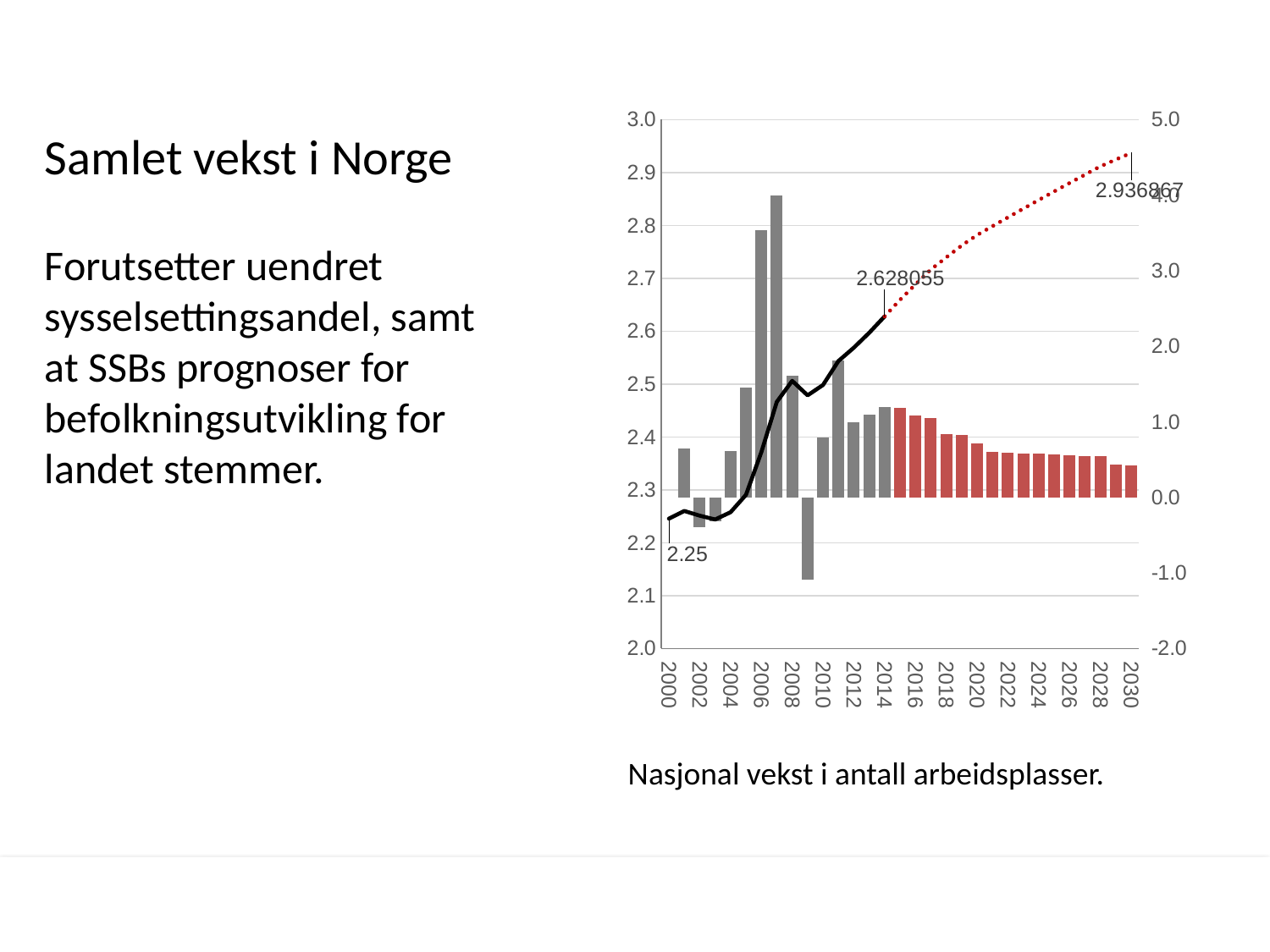
On the right-hand axis, is the bar for 2007 greater or less than 3.0? greater Which year has the tallest bar in the chart? 2007 What is the difference between the labelled line values at 2014 and 2000? 0.378055 What is the difference between the labelled line values at 2030 and 2014? 0.308812 Which is larger, the labelled line value at 2014 or at 2030? 2030 What is the value of the line at 2030, as labelled on the chart? 2.936867 What is the value of the line at 2000, as labelled on the chart? 2.25 What is the value of the line at 2014, as labelled on the chart? 2.628055 On the right-hand axis, is the bar for 2009 greater or less than 0.0? less Does the dotted line rise or fall from 2014 to 2030? rise What kind of chart is shown on the slide? Combined bar and line chart Which year has the lowest (most negative) bar in the chart? 2009